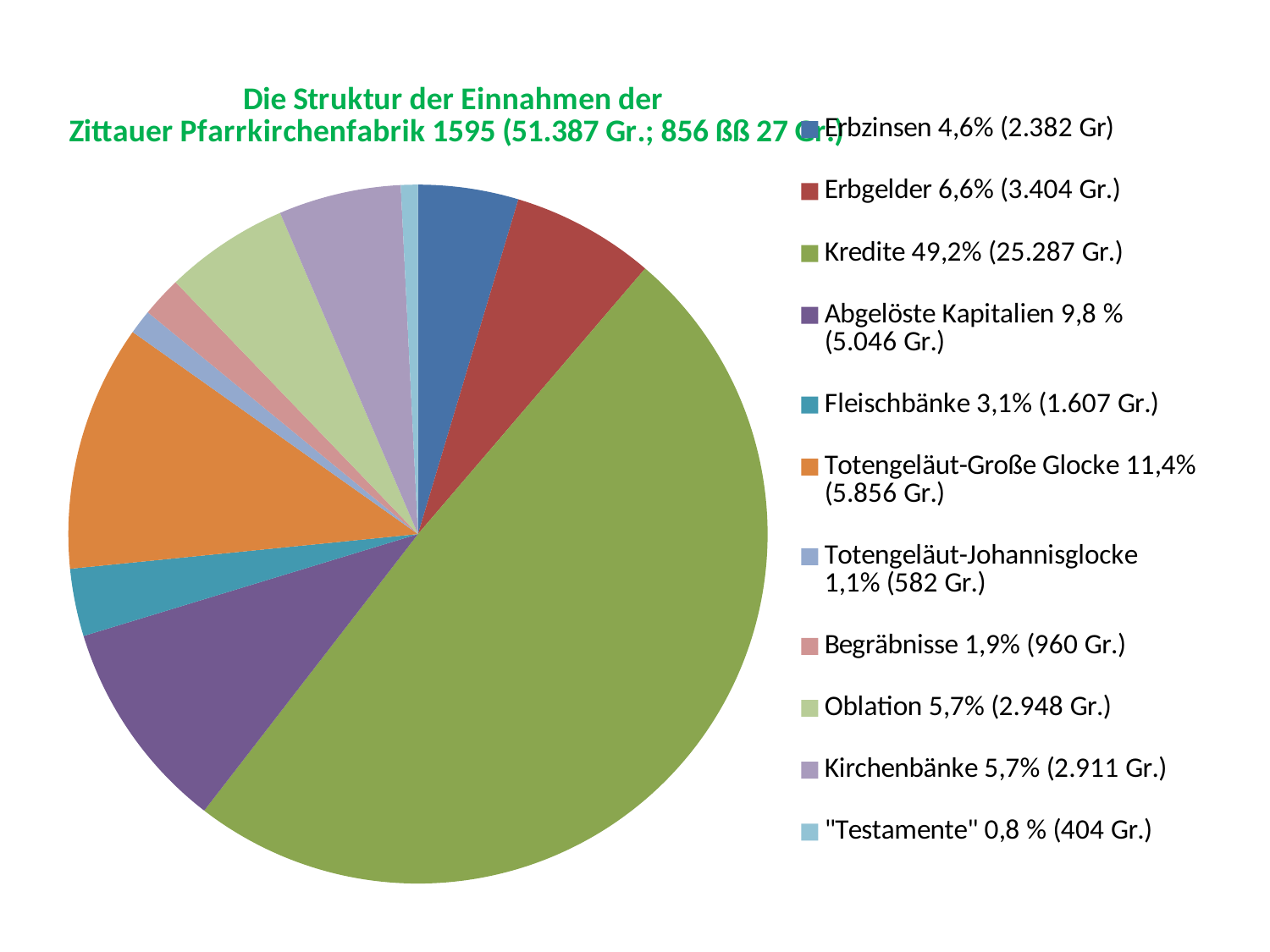
What is the value shown for Totengeläut-Große Glocke? 5.856 Gr. Which is larger, Begräbnisse or Totengeläut-Johannisglocke? Begräbnisse What share of the pie does Kredite account for? 49,2% What kind of chart is shown on the slide? pie chart Which year does the chart title refer to? 1595 What is the difference in Gr. between Oblation and Kirchenbänke? 37 Gr. How many categories does the pie chart's legend list? 11 What is the value shown for Fleischbänke? 1.607 Gr. Which category has the smallest share of the pie? "Testamente" Which category has the largest share of the pie? Kredite What share of the pie does Abgelöste Kapitalien account for? 9,8 % Which is larger, Erbgelder or Erbzinsen? Erbgelder